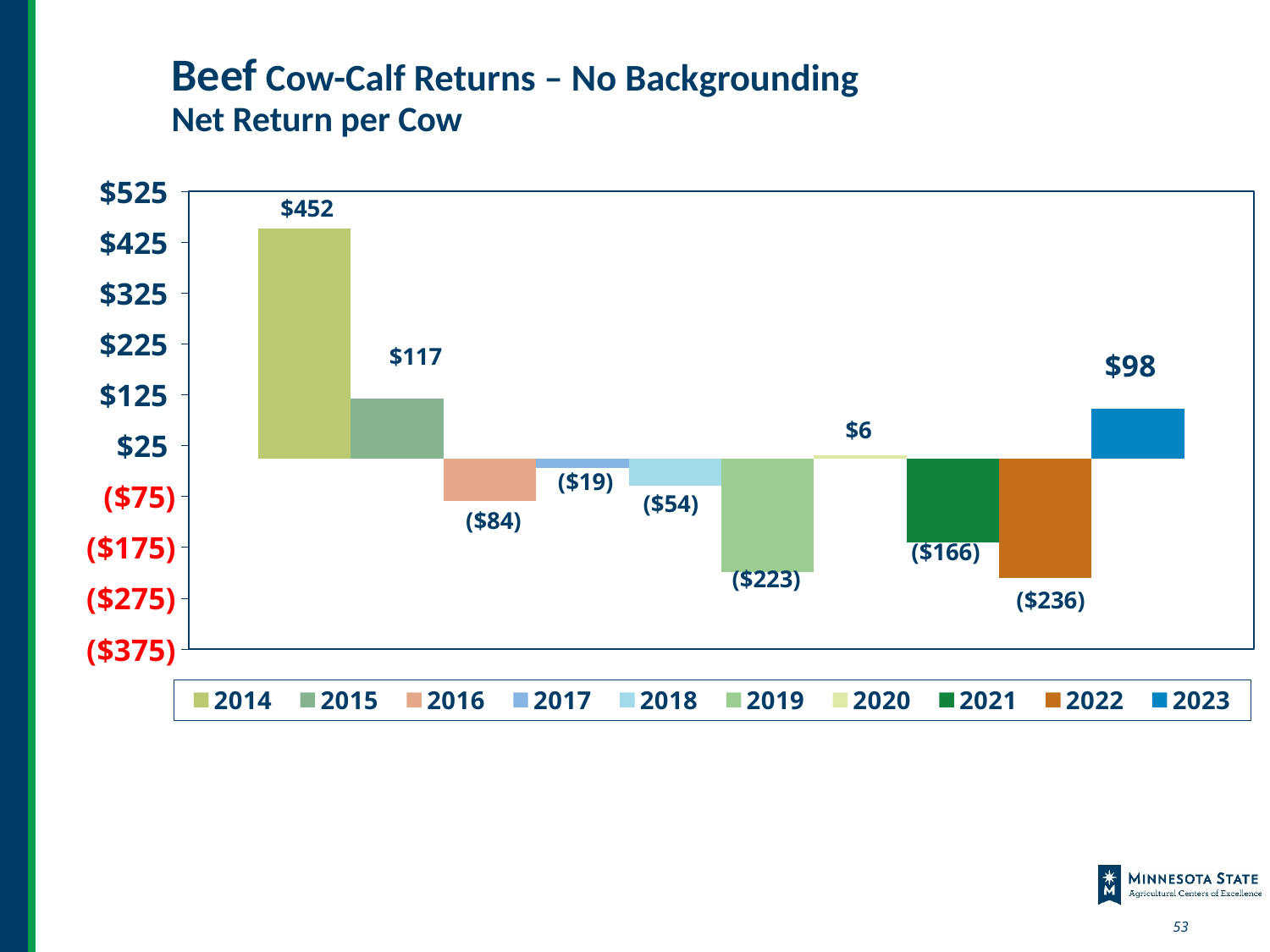
Which year has the highest net return per cow? 2014 What is the net return per cow for 2020? $6 What is the difference between the net return per cow in 2014 and in 2015? $335 What is the net return per cow for 2022? ($236) What is the net return per cow for 2014? $452 Which year has a larger net return per cow, 2015 or 2023? 2015 Which year has the lowest net return per cow? 2022 How many years are shown in the chart? 10 What is the net return per cow for 2023? $98 What kind of chart is shown on the slide? bar chart How many entries does the legend list? 10 Is the net return per cow for 2019 greater or less than ($175)? less